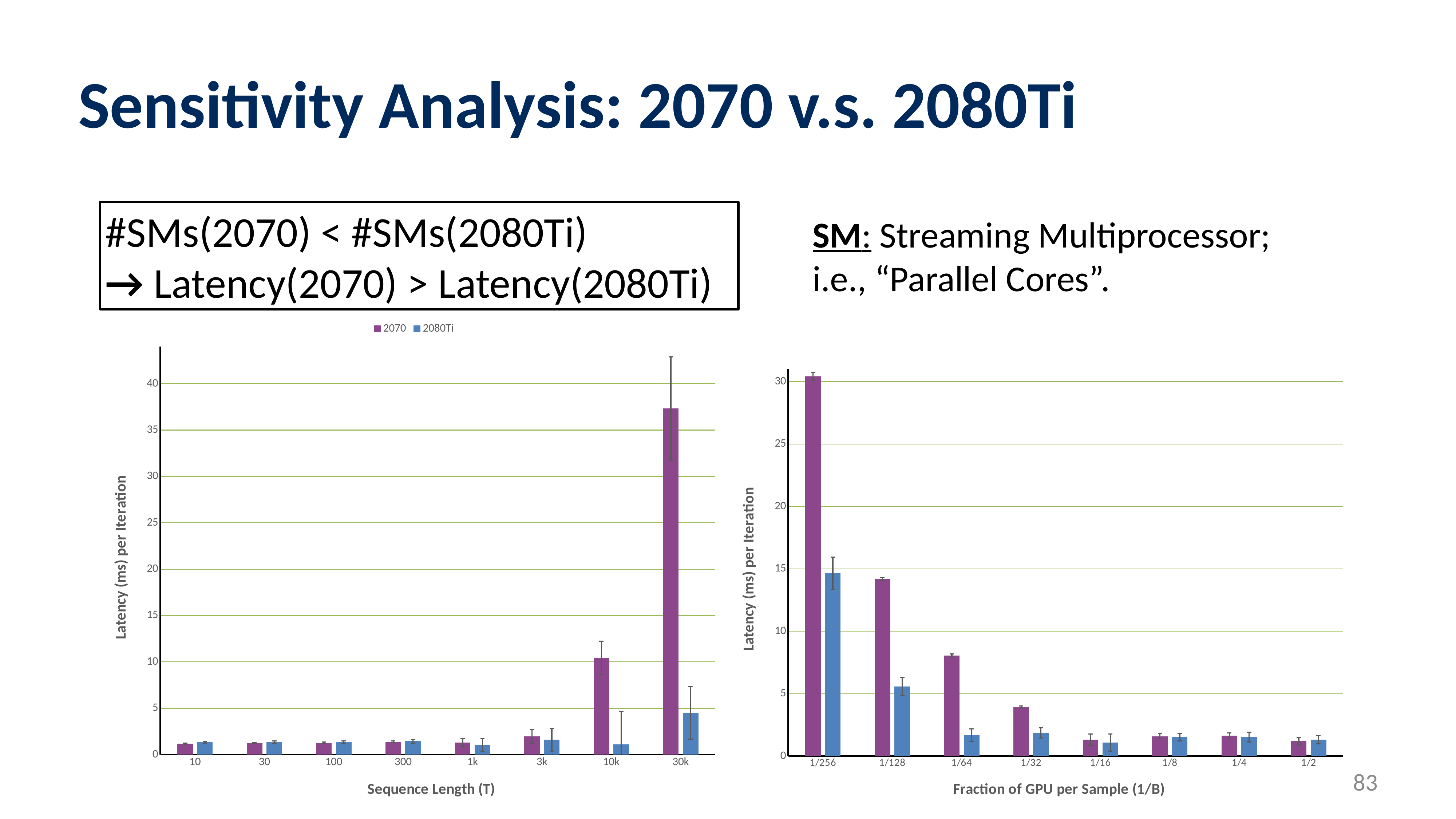
In the left chart (Sequence Length), how many sequence-length categories are shown on the x axis? 8 In the left chart (Sequence Length), at sequence length 30k, which series has the larger latency, 2070 or 2080Ti? 2070 In the right chart (Fraction of GPU per Sample), is the 2070 value at 1/64 greater or less than 10? less In the right chart (Fraction of GPU per Sample), does the 2070 latency rise or fall from 1/256 to 1/16? fall What kind of chart is the left chart (Sequence Length)? bar chart In the left chart (Sequence Length), is the 2080Ti value at 30k greater or less than 10? less In the left chart (Sequence Length), at which sequence length is the 2070 latency highest? 30k In the right chart (Fraction of GPU per Sample), how many categories are shown on the x axis? 8 In the right chart (Fraction of GPU per Sample), is the 2070 value at 1/256 greater or less than 25? greater How many series does the legend list? 2 In the right chart (Fraction of GPU per Sample), at which fraction is the 2070 latency highest? 1/256